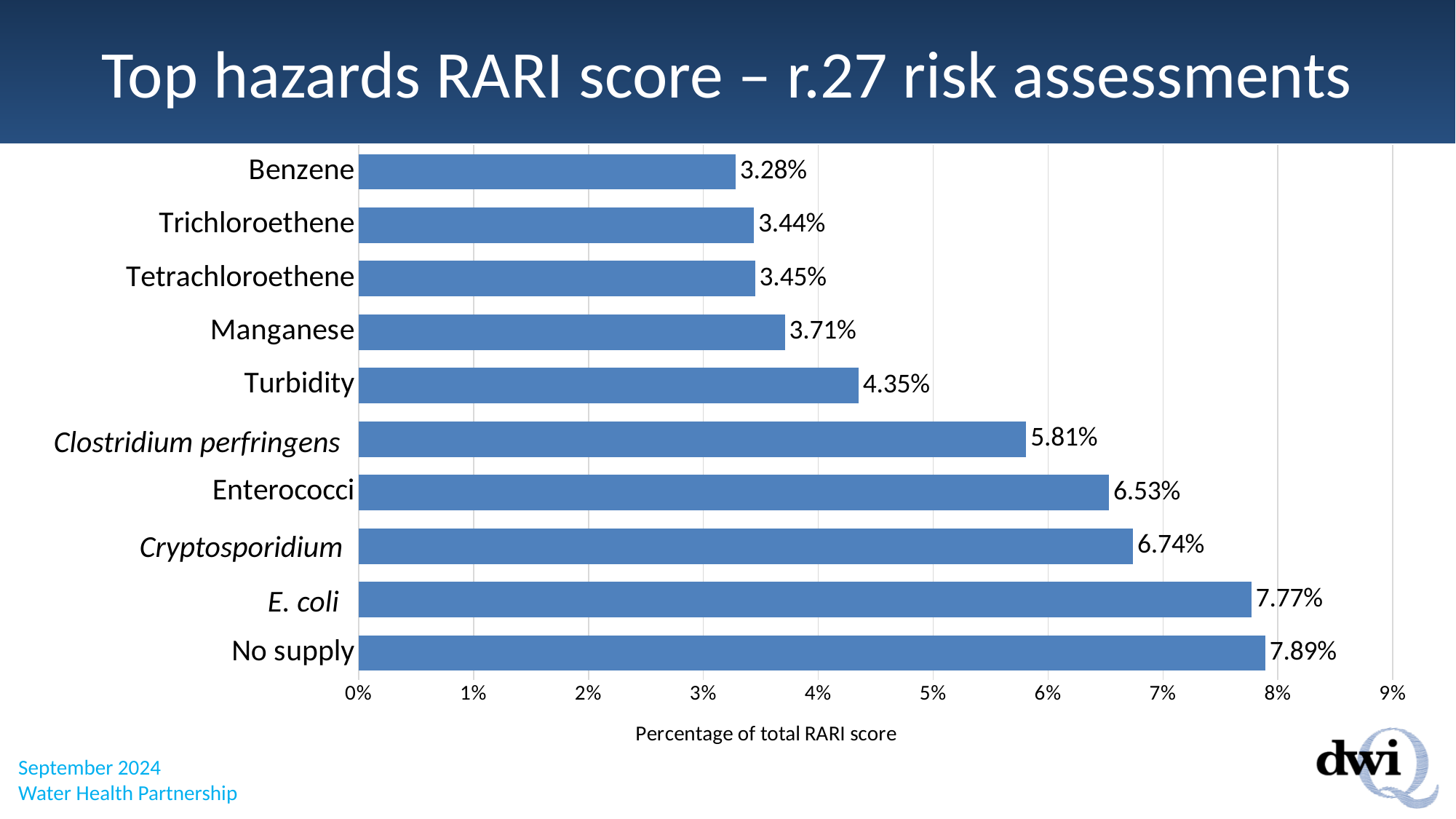
What is the difference between the percentages for E. coli and Enterococci? 1.24% Which hazard has the highest percentage of total RARI score? No supply What is the percentage of total RARI score for Manganese? 3.71% Is the value for Enterococci greater or less than 6%? greater How many hazards are shown in the chart? 10 What is the title of the slide? Top hazards RARI score – r.27 risk assessments Which has a larger percentage of total RARI score, Clostridium perfringens or Turbidity? Clostridium perfringens What is the percentage of total RARI score for Turbidity? 4.35% Which hazard has the lowest percentage of total RARI score? Benzene What kind of chart is shown on the slide? Bar chart What is the label of the horizontal axis? Percentage of total RARI score What is the percentage of total RARI score for Cryptosporidium? 6.74%